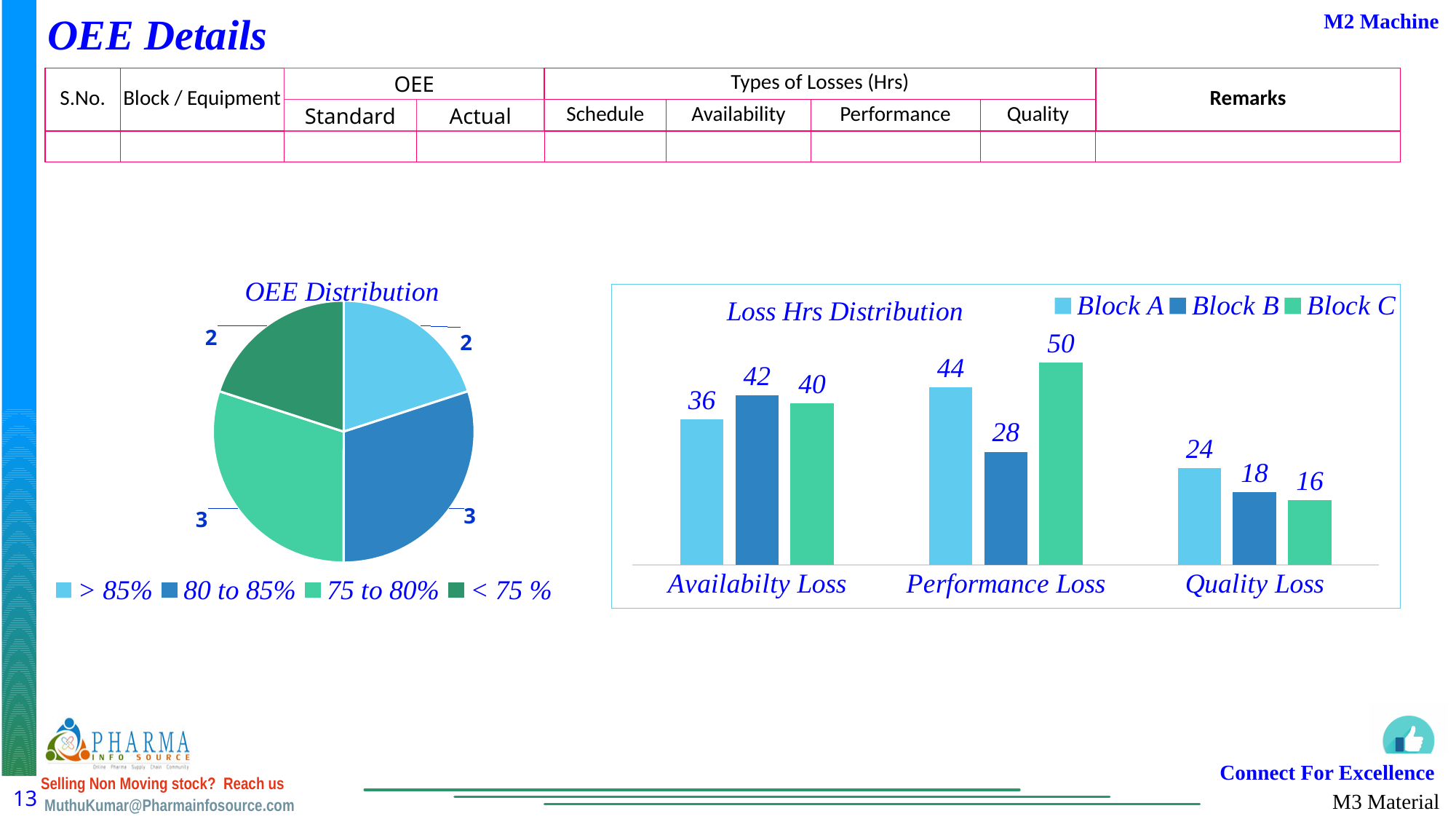
In the Loss Hrs Distribution chart, what is the value for Block B under Performance Loss? 28 In the Loss Hrs Distribution chart, what is the value for Block C under Availabilty Loss? 40 How many slices does the OEE Distribution pie chart have? 4 In the OEE Distribution pie chart, what is the value for the 80 to 85% slice? 3 In the Loss Hrs Distribution chart, which is larger: Block A under Availabilty Loss or Block A under Performance Loss? Block A under Performance Loss In the Loss Hrs Distribution chart, what is the difference between Block A and Block B under Quality Loss? 6 What kind of chart is the Loss Hrs Distribution chart? Bar chart How many loss categories are shown on the x axis of the Loss Hrs Distribution chart? 3 How many series does the legend of the Loss Hrs Distribution chart list? 3 In the OEE Distribution pie chart, what share of the total does the > 85% slice represent? 20% In the Loss Hrs Distribution chart, which block has the highest value under Performance Loss? Block C In the Loss Hrs Distribution chart, which block has the lowest value under Quality Loss? Block C